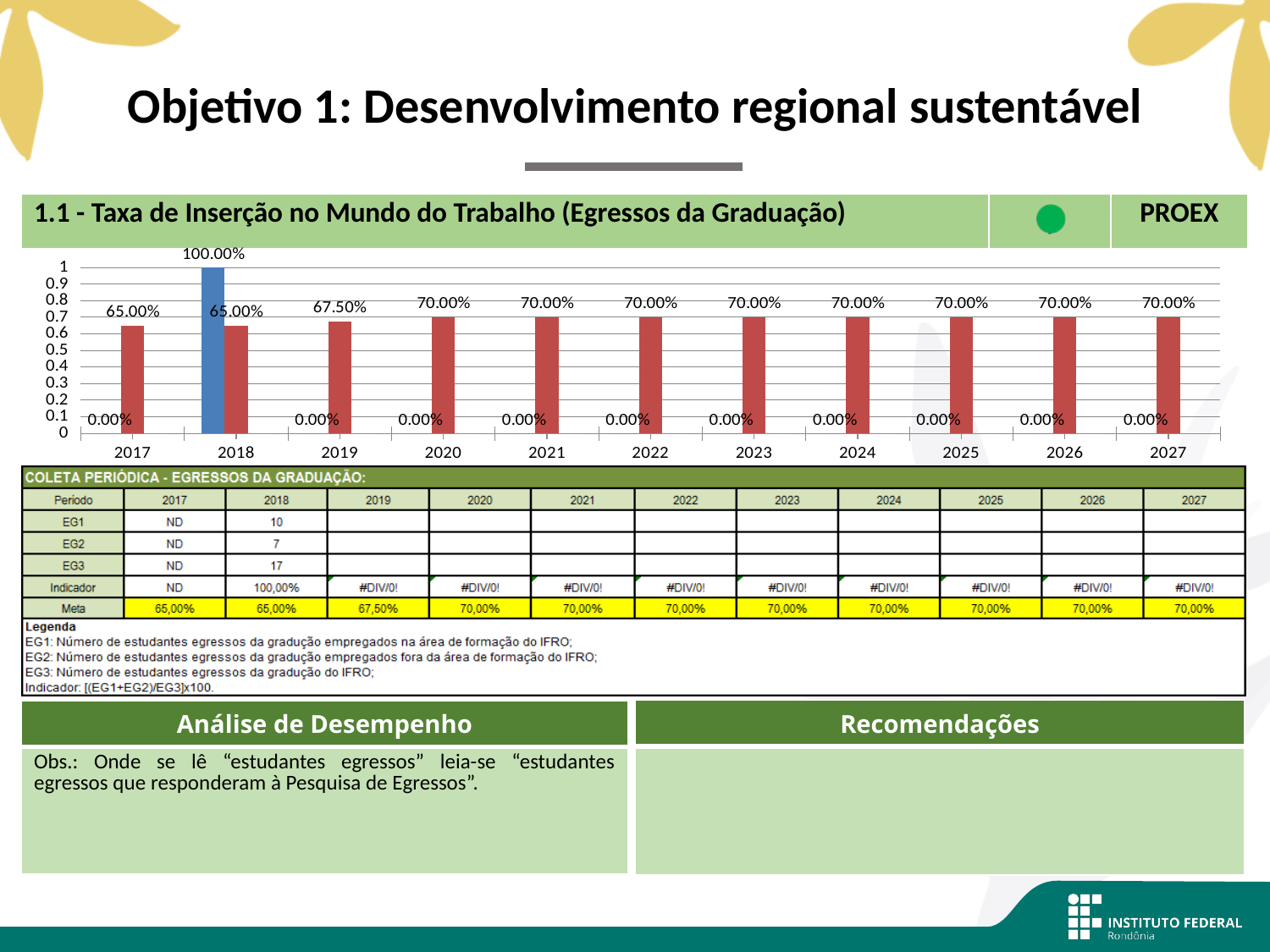
Which year has the tallest bar in the chart? 2018 What is the title of the indicator shown above the chart? 1.1 - Taxa de Inserção no Mundo do Trabalho (Egressos da Graduação) What is the value of the blue bar for 2018? 100.00% Do the red bar values rise or fall from 2017 to 2020? rise Which is larger, the red bar for 2019 or the red bar for 2018? 2019 How many years are shown on the x axis of the chart? 11 What is the value of the blue bar for 2022? 0.00% What is the value of the red bar for 2025? 70.00% What is the value of the red bar for 2017? 65.00% What is the value of the red bar for 2019? 67.50% What type of chart is shown on the slide? bar chart What is the difference between the red bar values for 2020 and 2017? 5.00%